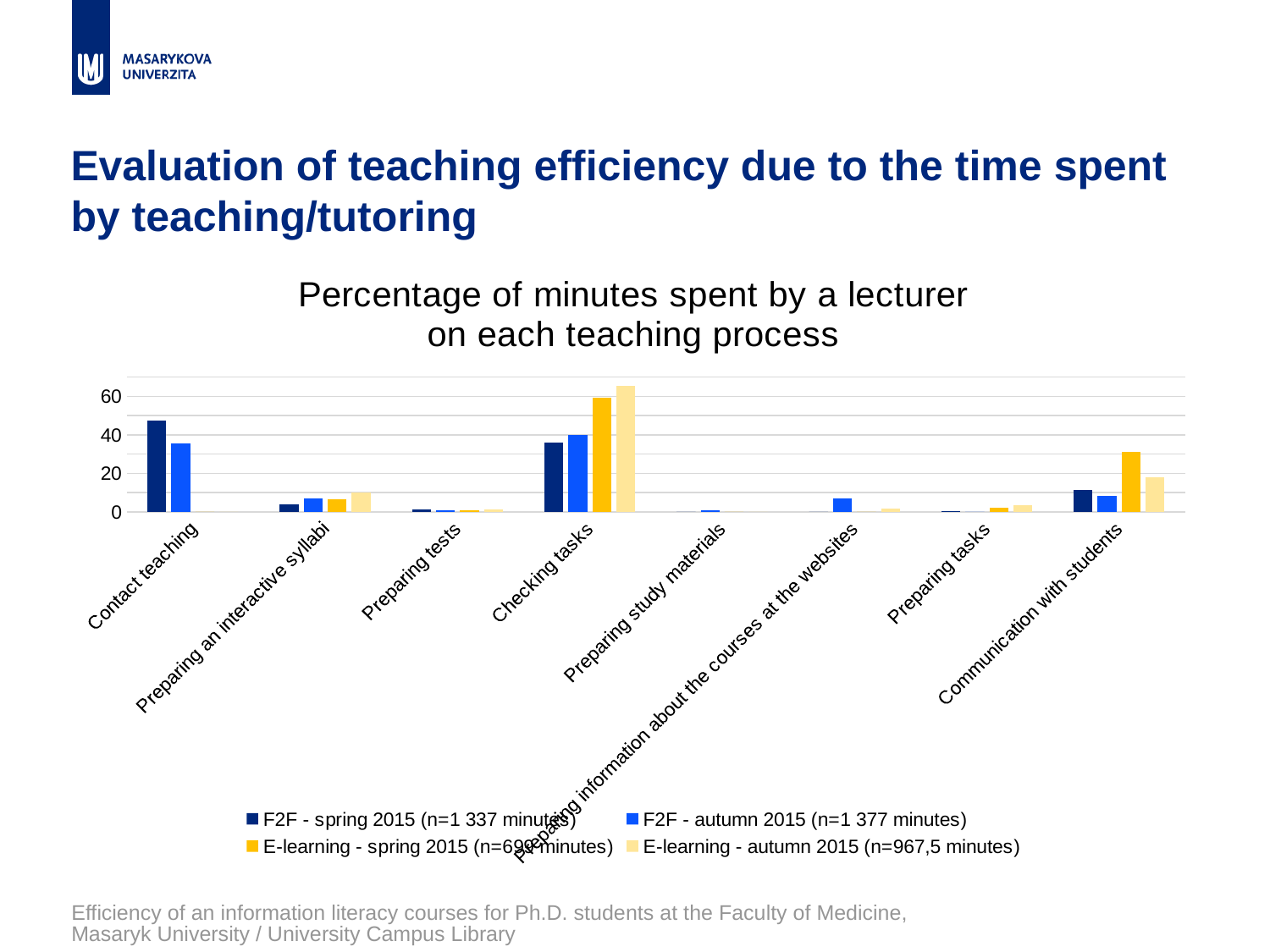
For Checking tasks, which series has the larger value: F2F - spring 2015 or E-learning - spring 2015? E-learning - spring 2015 Which category has the highest value for the F2F - spring 2015 series? Contact teaching Is the value for Checking tasks in the E-learning - autumn 2015 series greater or less than 60? greater Which series is shown in the darkest blue colour in the legend? F2F - spring 2015 (n=1 337 minutes) Is the value for Communication with students in the E-learning - spring 2015 series greater or less than 20? greater How many series does the legend list? 4 Is the value for Contact teaching in the F2F - spring 2015 series greater or less than 40? greater How many teaching process categories are shown on the x axis? 8 What is the title of the chart? Percentage of minutes spent by a lecturer on each teaching process What kind of chart is shown on the slide? bar chart Which category has the highest value for the E-learning - autumn 2015 series? Checking tasks For Contact teaching, which series has the larger value: F2F - spring 2015 or F2F - autumn 2015? F2F - spring 2015